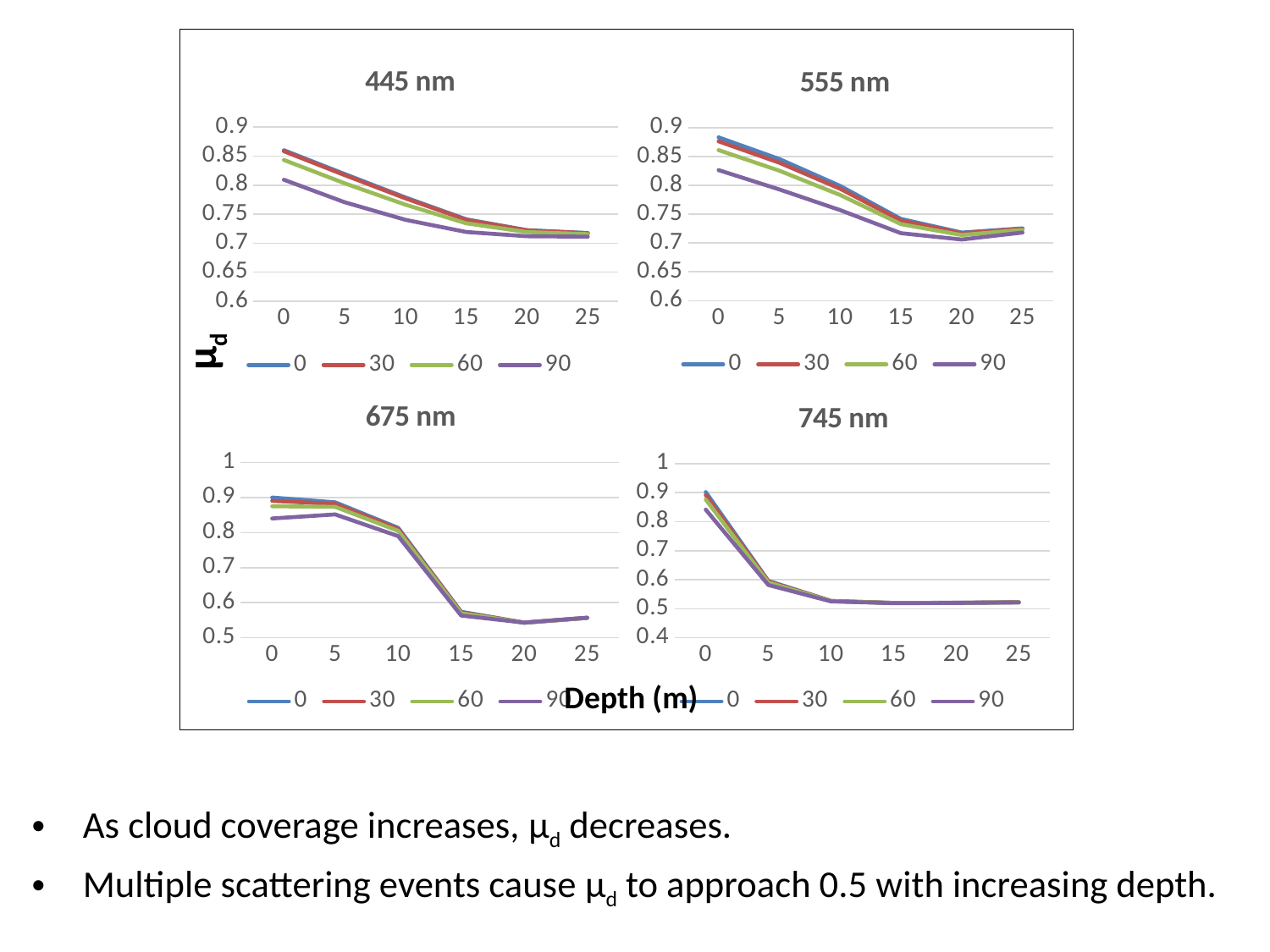
In the 555 nm chart, which series has the lowest value at depth 0? 90 In the 555 nm chart, is the value for series 0 at depth 0 greater or less than 0.85? greater What is the title of the bottom-left chart? 675 nm In the 675 nm chart, is the value for series 0 at depth 20 greater or less than 0.6? less How many depth points are plotted along the x axis of the 675 nm chart? 6 What kind of chart is the 445 nm chart? line chart In the 745 nm chart, is the value for series 0 at depth 0 greater or less than 0.8? greater How many series does the legend of the 555 nm chart list? 4 In the 445 nm chart at depth 0, which series has the higher value, 0 or 90? 0 In the 745 nm chart, do the values rise or fall as depth increases from 0 to 25? fall What label is given to the x axis shared by the four charts? Depth (m)